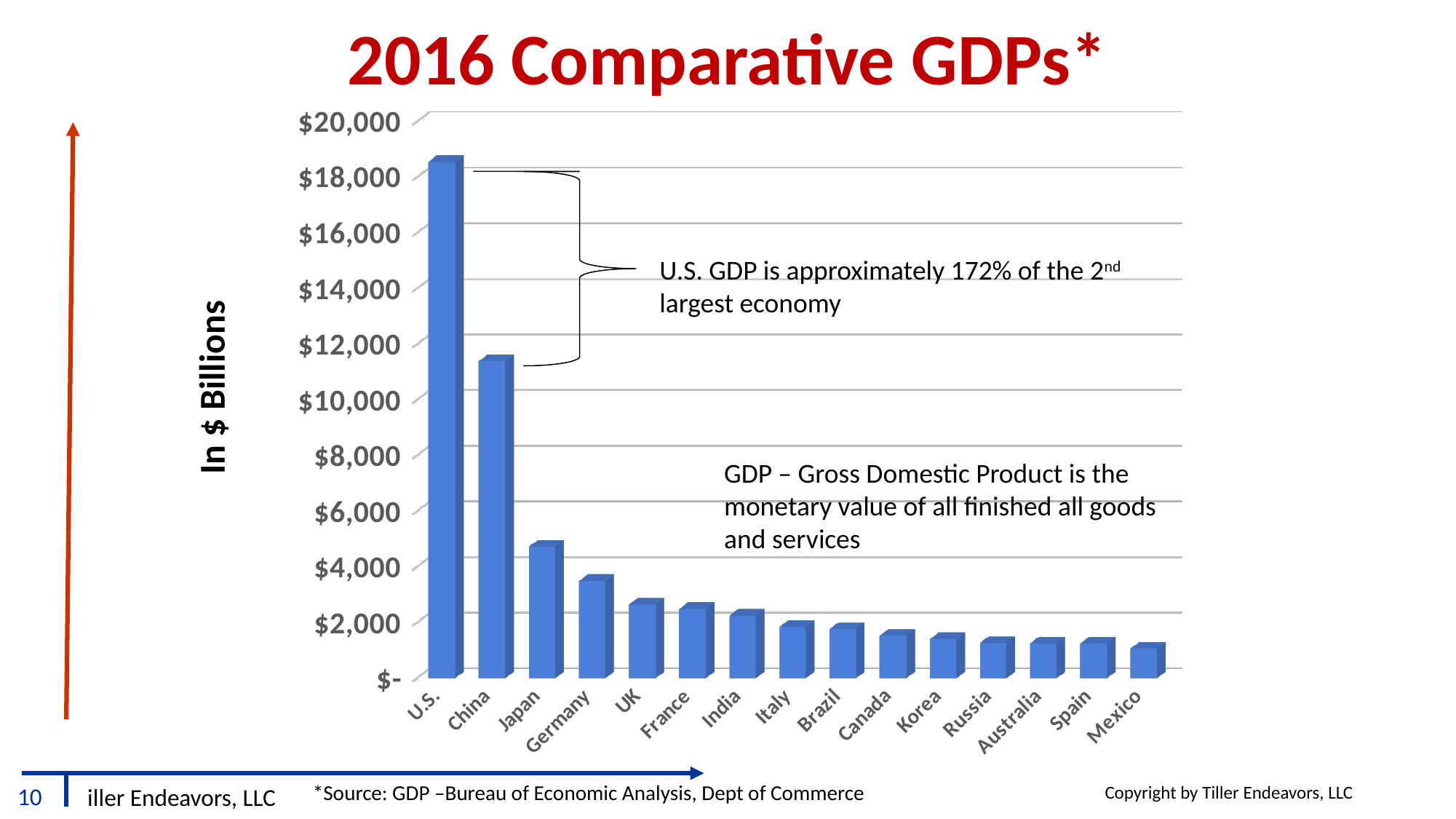
Is the value for the U.S. greater or less than $16,000? greater Which has the larger GDP, Japan or Germany? Japan What kind of chart is shown on the slide? bar chart Is the value for Mexico greater or less than $2,000? less Which has the larger GDP, the U.S. or China? U.S. Is the value for Japan greater or less than $4,000? greater Do the values rise or fall moving from left to right along the x axis? fall How many countries are plotted on the chart? 15 What is the label on the vertical axis of the chart? In $ Billions Which country has the lowest GDP on the chart? Mexico Which country has the highest GDP on the chart? U.S.